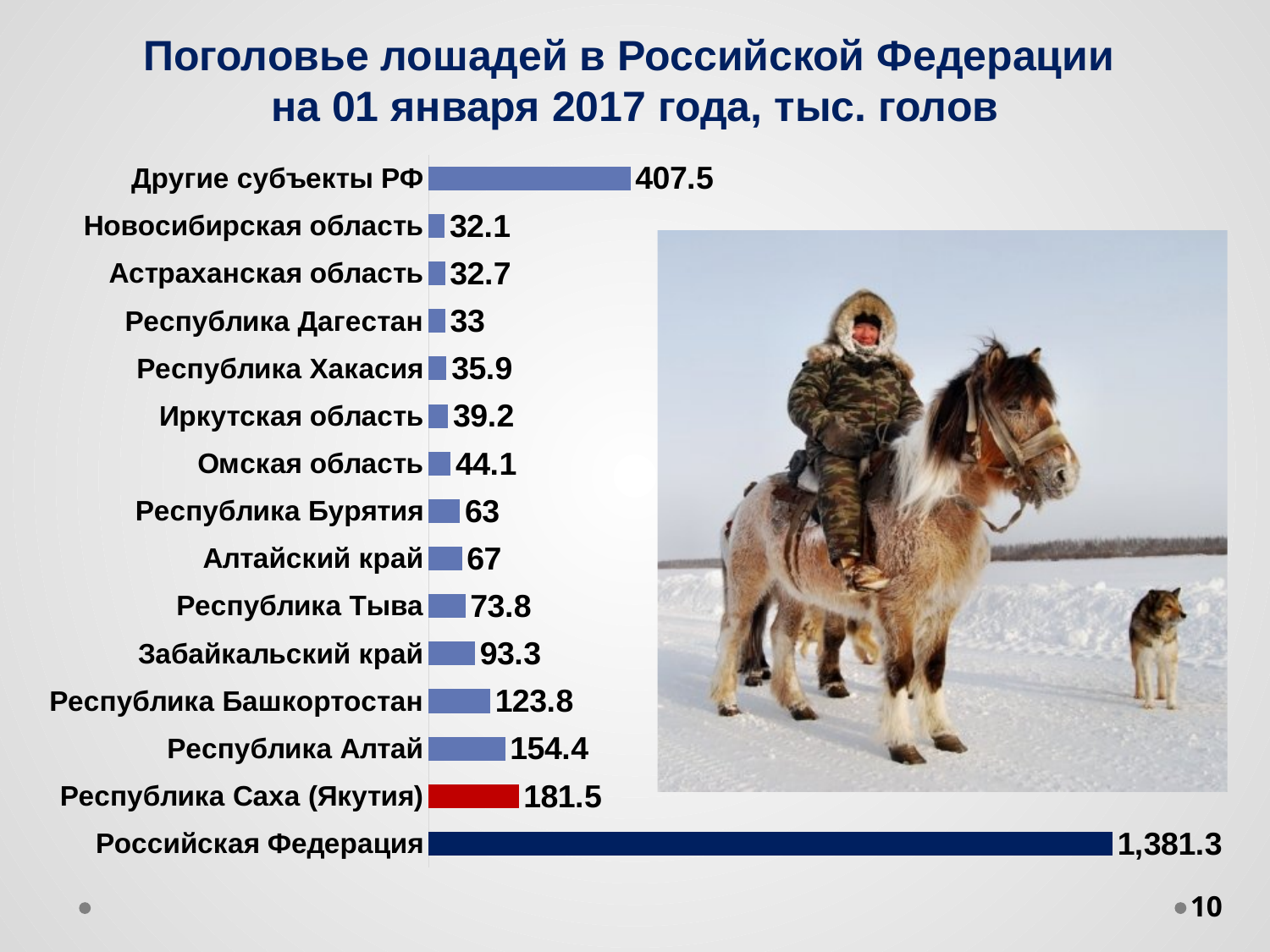
Which category has the highest value? Российская Федерация Which is larger, the value for Республика Тыва or for Алтайский край? Республика Тыва What kind of chart is shown on the slide? Bar chart What is the value for Республика Саха (Якутия)? 181.5 What is the value for Другие субъекты РФ? 407.5 What is the value for Республика Башкортостан? 123.8 Which category's bar is coloured red? Республика Саха (Якутия) How many categories are shown in the chart? 15 What is the value for Российская Федерация? 1,381.3 What is the difference between the values for Республика Саха (Якутия) and Республика Алтай? 27.1 What is the difference between the values for Забайкальский край and Республика Тыва? 19.5 Which category has the lowest value? Новосибирская область